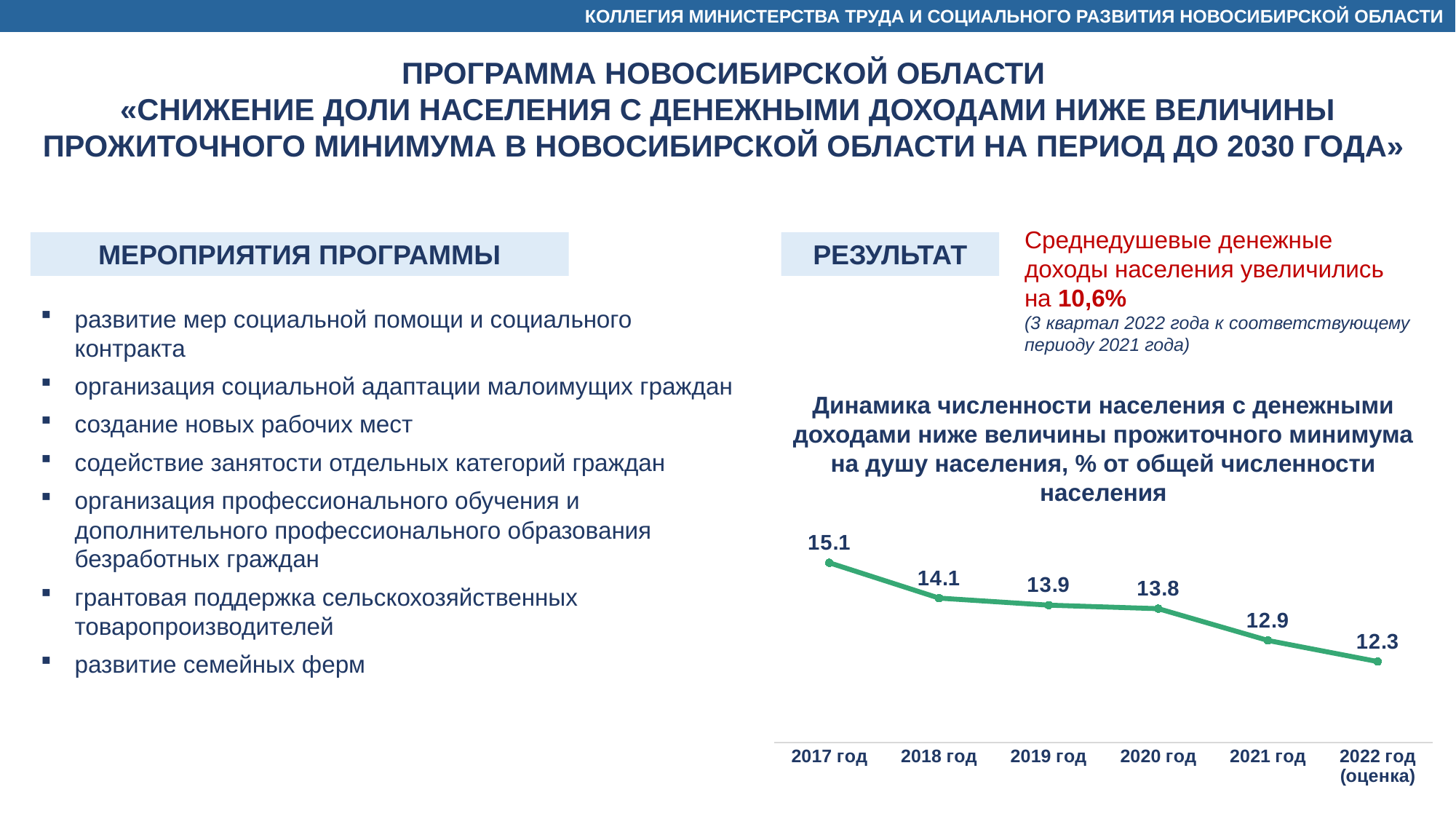
What kind of chart is shown? line chart What is the value for 2020 год? 13.8 What is the difference between the values for 2017 год and 2022 год (оценка)? 2.8 What is the value for 2017 год? 15.1 What is the value for 2022 год (оценка)? 12.3 How many years are plotted on the chart? 6 Do the values rise or fall from 2017 год to 2022 год (оценка)? fall What colour is the line on the chart? green What is the difference between the values for 2018 год and 2021 год? 1.2 Which year has the lowest value? 2022 год (оценка) Which is larger, the value for 2018 год or the value for 2021 год? 2018 год Which year has the highest value? 2017 год